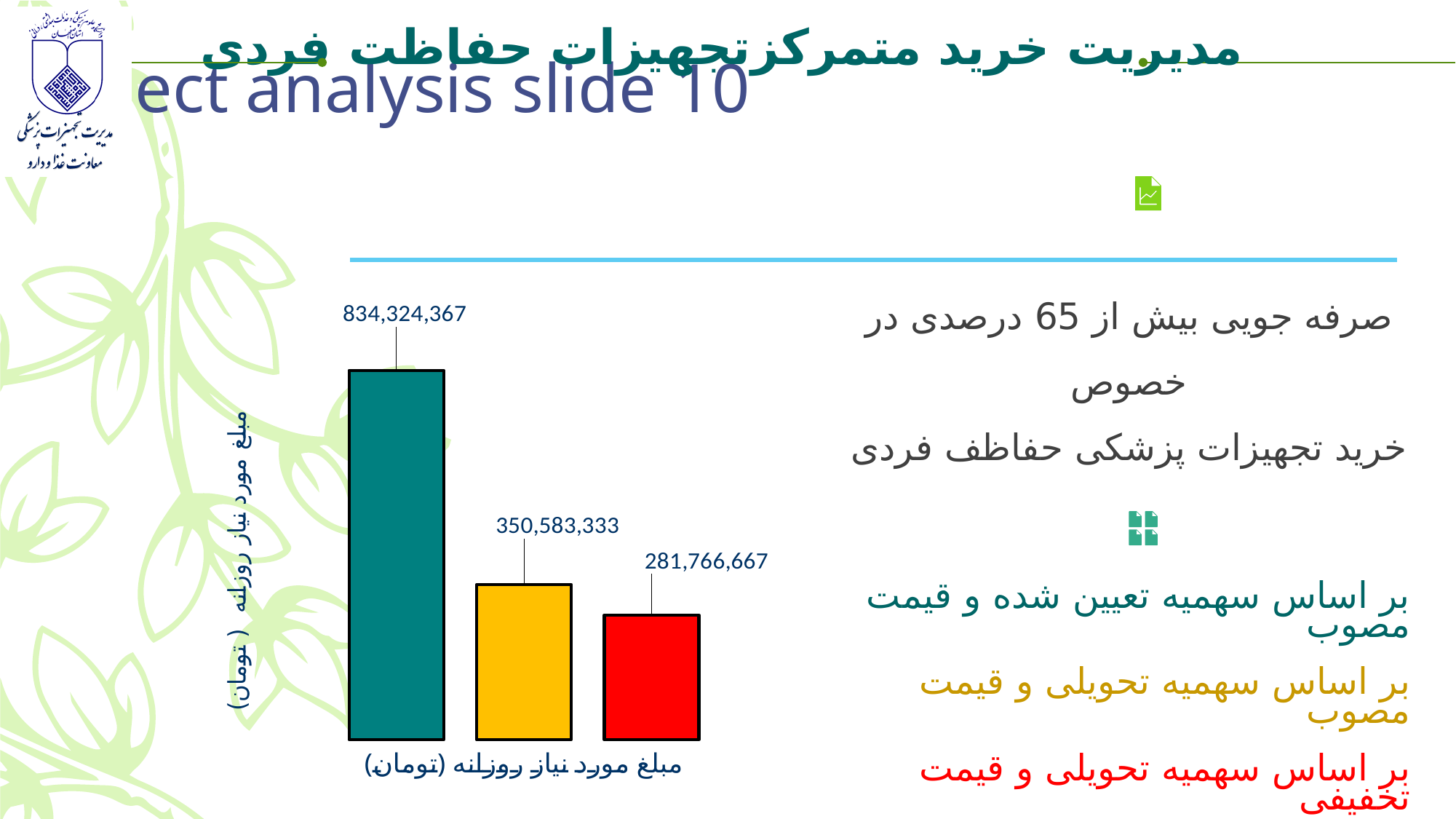
What is the value shown on the teal bar? 834,324,367 What is the difference between the yellow bar and the red bar? 68,816,666 Which is larger, the yellow bar or the red bar? the yellow bar Which bar has the highest value? the teal bar (بر اساس سهمیه تعیین شده و قیمت مصوب) What is the value shown on the yellow bar? 350,583,333 What is the value for the series 'بر اساس سهمیه تحویلی و قیمت تخفیفی'? 281,766,667 What is the label on the x axis of the chart? مبلغ مورد نیاز روزانه (تومان) What type of chart is shown on the slide? bar chart What is the difference between the teal bar and the yellow bar? 483,741,034 Which bar has the lowest value? the red bar (بر اساس سهمیه تحویلی و قیمت تخفیفی) How many bars are plotted in the chart? 3 What is the value shown on the red bar? 281,766,667